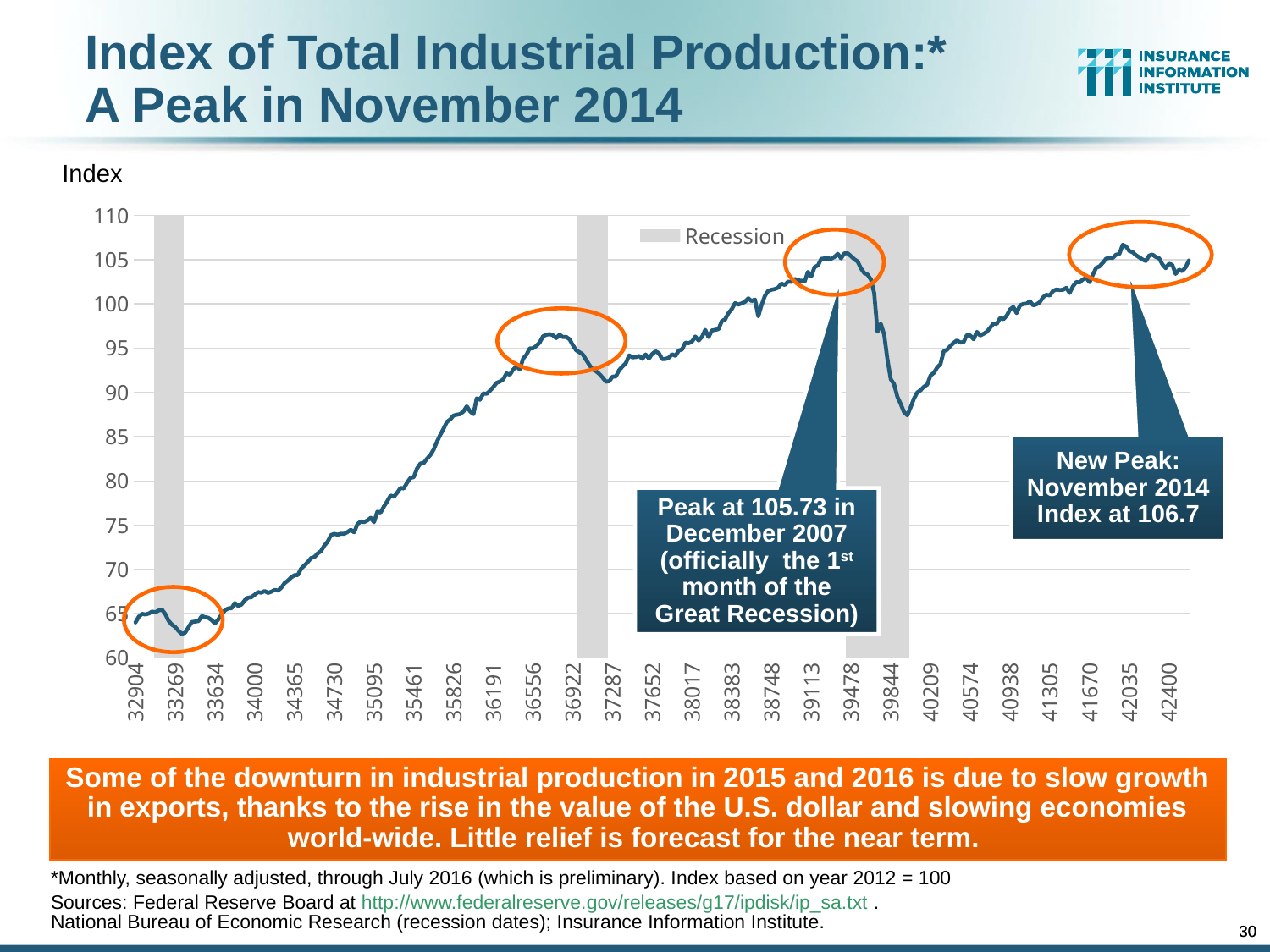
What do the gray shaded vertical bands on the chart represent? Recession Is the index value at the far right of the chart (x = 42400) greater or less than 100? greater How many recession periods are shaded on the chart? 3 What kind of chart is shown on the slide? line chart What was the value of the Index of Total Industrial Production at its peak in December 2007? 105.73 Over the whole period shown, does the index generally rise or fall from left to right? rise Is the lowest point of the index after the December 2007 peak greater or less than 90? less Is the index value at the far left of the chart (x = 32904) greater or less than 70? less Which peak was higher: December 2007 or November 2014? November 2014 By how much does the November 2014 peak (106.7) exceed the December 2007 peak (105.73)? 0.97 What was the index value at the new peak in November 2014? 106.7 What is the only entry shown in the chart's legend? Recession